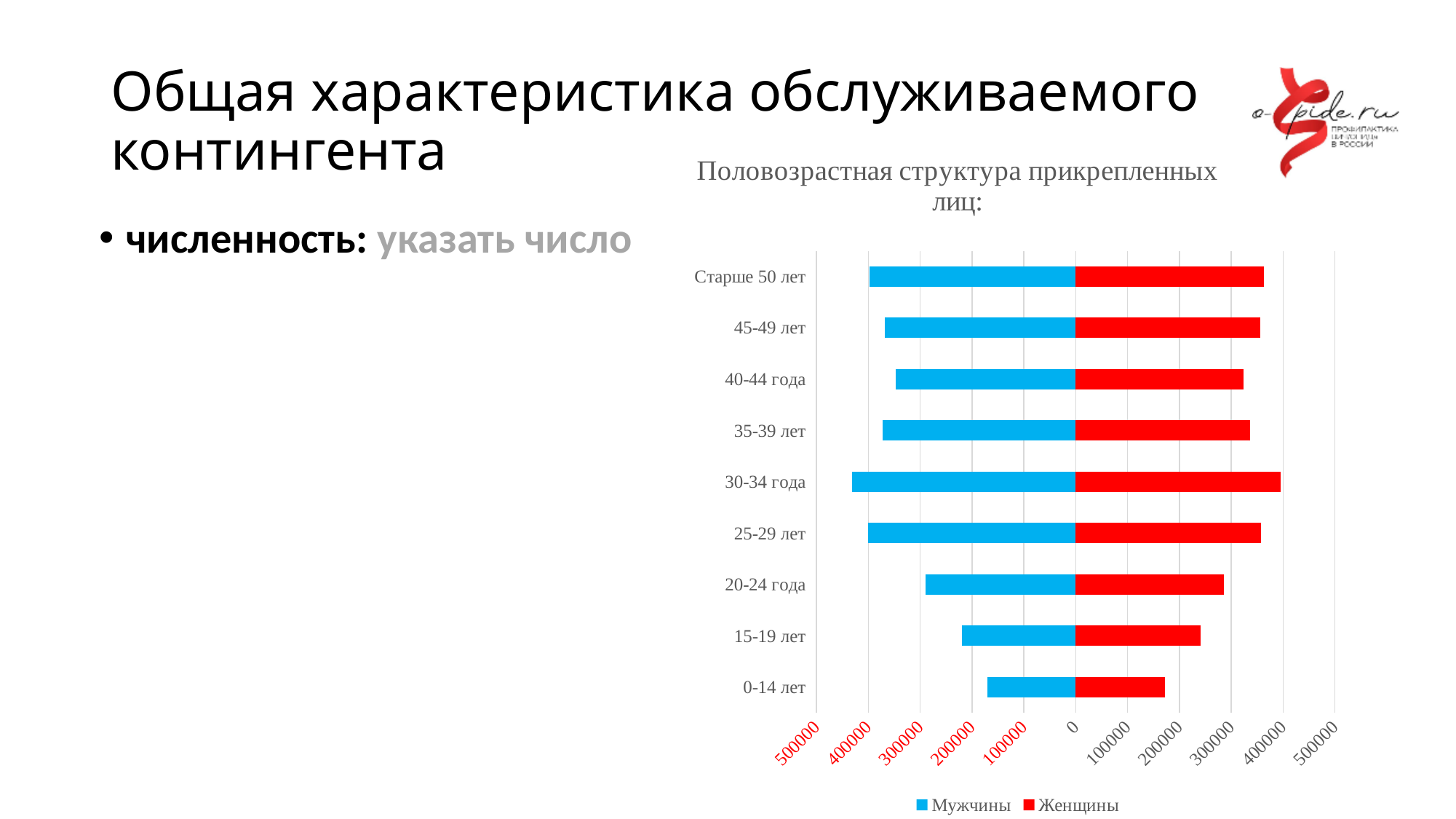
Which age group has the smallest value for Мужчины? 0-14 лет Which is larger for Женщины: the 30-34 года group or the 20-24 года group? 30-34 года How many age groups are shown on the chart? 9 How many series does the chart legend list? 2 Which age group has the largest value for Женщины? 30-34 года Which age group has the smallest value for Женщины? 0-14 лет What kind of chart is shown on the slide? bar chart Is the value for Женщины in the 30-34 года group greater or less than 300000? greater What is the title of the chart? Половозрастная структура прикрепленных лиц: Which series are listed in the chart legend? Мужчины, Женщины Which age group has the largest value for Мужчины? 30-34 года Is the value for Мужчины in the 0-14 лет group greater or less than 200000? less